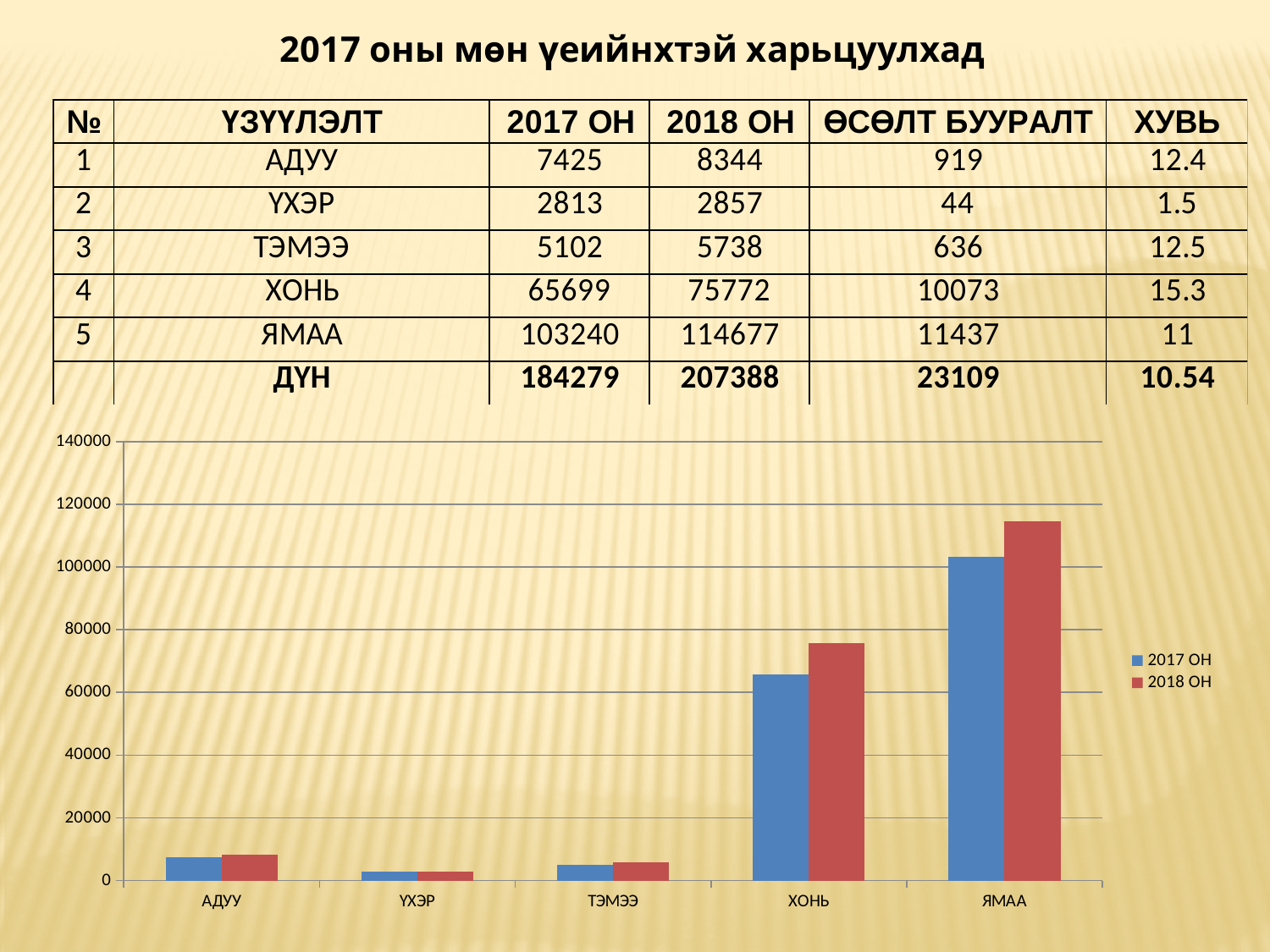
Which category has the highest 2018 ОН bar in the chart? ЯМАА How many categories are shown on the x axis of the chart? 5 How many series does the chart legend list? 2 Which category has the lowest 2017 ОН bar in the chart? ҮХЭР Is the 2018 ОН value for ЯМАА greater or less than 120000? less What colour are the 2018 ОН bars in the chart? red Is the 2017 ОН value for ХОНЬ greater or less than 60000? greater What kind of chart is shown on the slide? bar chart According to the table on the slide, what is the 2017 ОН value for ХОНЬ plotted in the chart? 65699 Is the 2018 ОН value for ХОНЬ greater or less than 80000? less For ХОНЬ, which bar is taller: 2017 ОН or 2018 ОН? 2018 ОН Which is larger in the chart: the 2017 ОН bar for ХОНЬ or the 2017 ОН bar for ЯМАА? ЯМАА